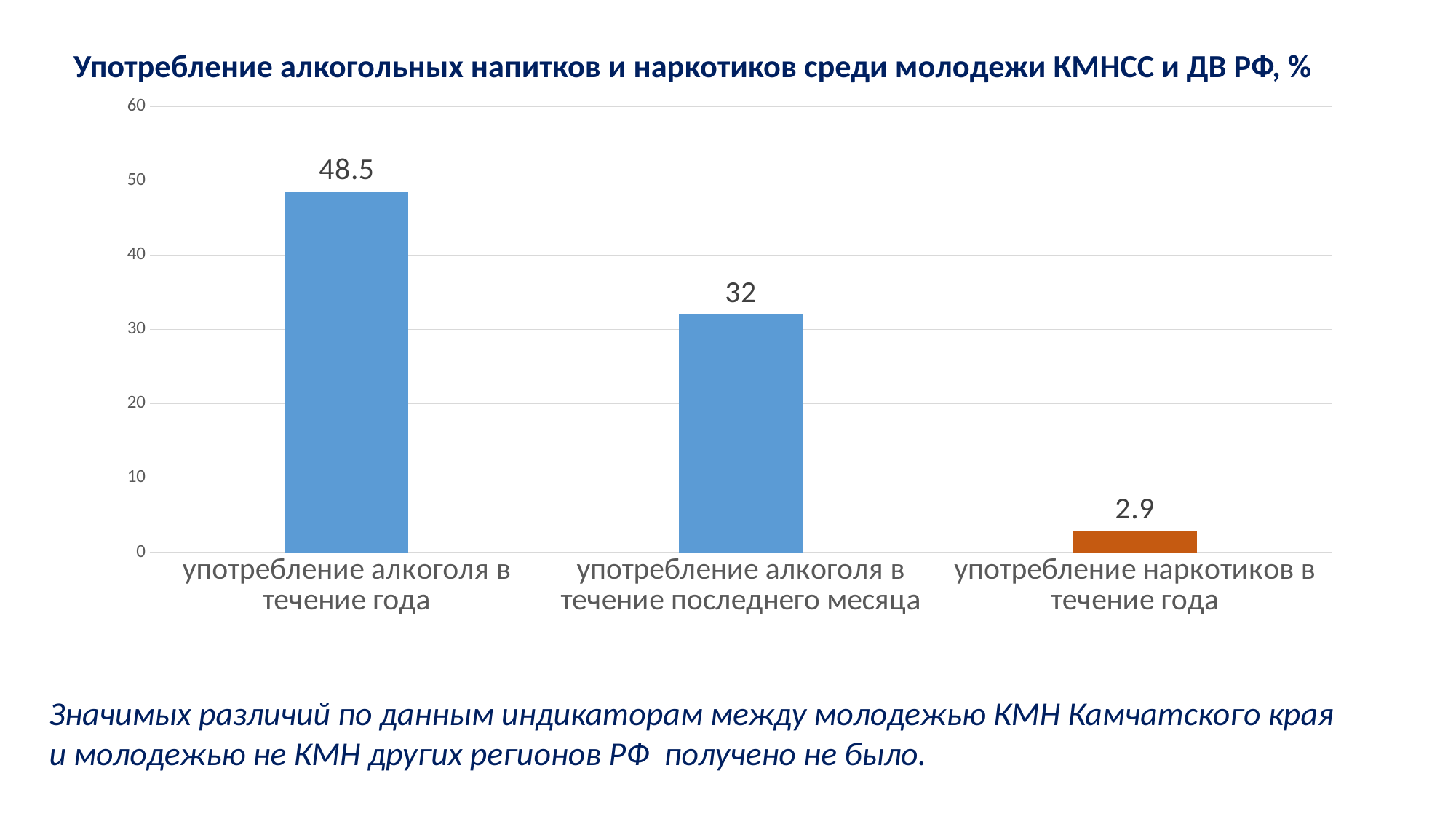
What is the value for "употребление алкоголя в течение последнего месяца"? 32 Is the value for "употребление алкоголя в течение года" greater or less than 40? greater What is the value for "употребление наркотиков в течение года"? 2.9 What is the value for "употребление алкоголя в течение года"? 48.5 What is the title of the chart? Употребление алкогольных напитков и наркотиков среди молодежи КМНСС и ДВ РФ, % What is the difference between the values for "употребление алкоголя в течение последнего месяца" and "употребление наркотиков в течение года"? 29.1 What is the difference between the values for "употребление алкоголя в течение года" and "употребление алкоголя в течение последнего месяца"? 16.5 How many categories are shown in the chart? 3 What kind of chart is shown on the slide? bar chart Which is larger: the value for "употребление алкоголя в течение последнего месяца" or for "употребление наркотиков в течение года"? употребление алкоголя в течение последнего месяца Which category has the lowest value? употребление наркотиков в течение года Which category has the highest value? употребление алкоголя в течение года